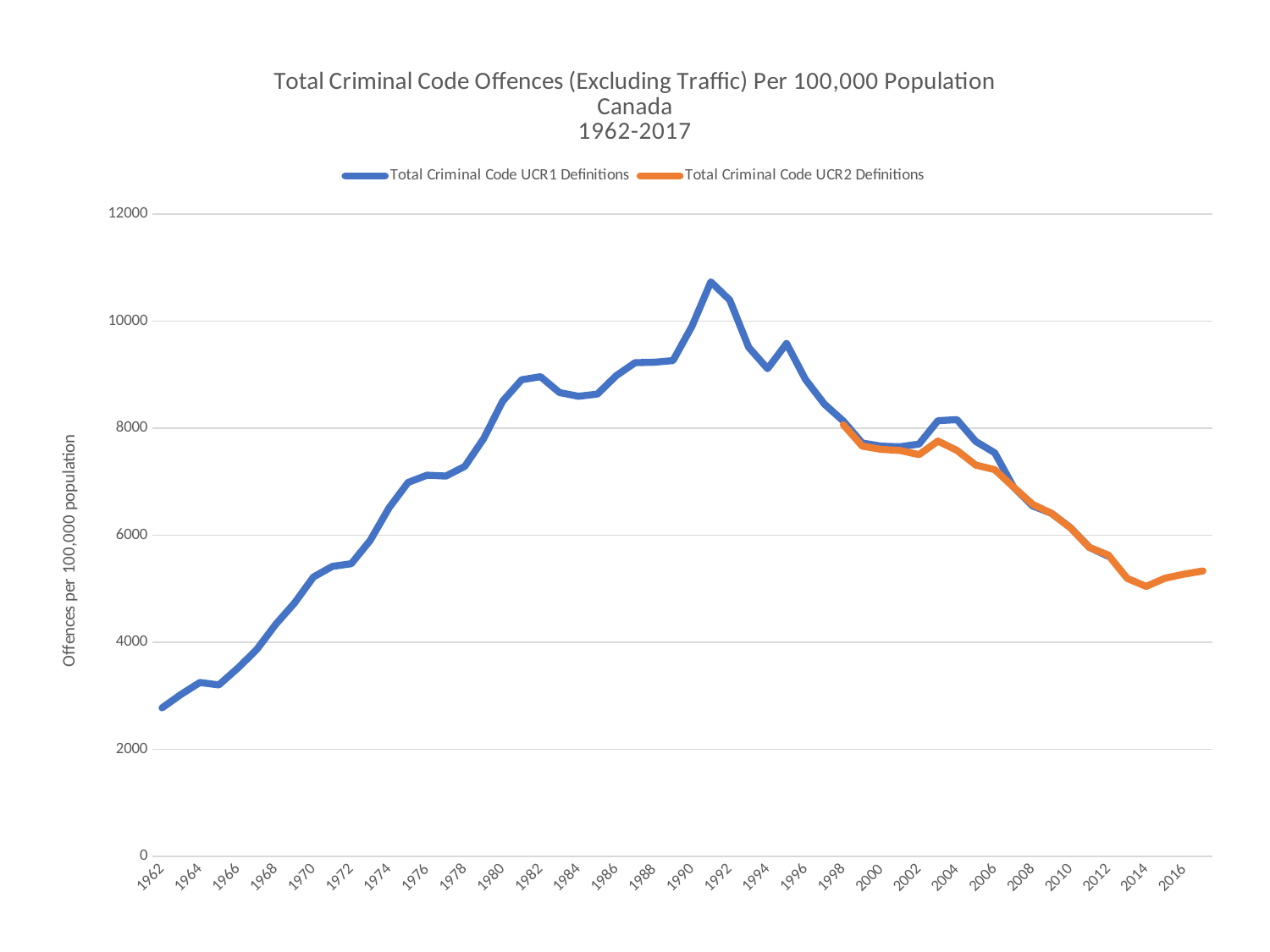
Is the value for the Total Criminal Code UCR1 Definitions series in 1962 greater or less than 4000? less In which year does the Total Criminal Code UCR1 Definitions series reach its highest value? 1991 Is the value for the Total Criminal Code UCR1 Definitions series in 1991 greater or less than 10000? greater Which colour represents the Total Criminal Code UCR2 Definitions series? orange Is the value for the Total Criminal Code UCR2 Definitions series in 2014 greater or less than 6000? less In which year does the Total Criminal Code UCR1 Definitions series have its lowest value? 1962 Does the Total Criminal Code UCR2 Definitions series generally rise or fall between 2003 and 2014? fall How many series does the legend list? 2 What is the title of the chart? Total Criminal Code Offences (Excluding Traffic) Per 100,000 Population Canada 1962-2017 What kind of chart is shown on the slide? line chart Does the Total Criminal Code UCR1 Definitions series generally rise or fall between 1962 and 1991? rise